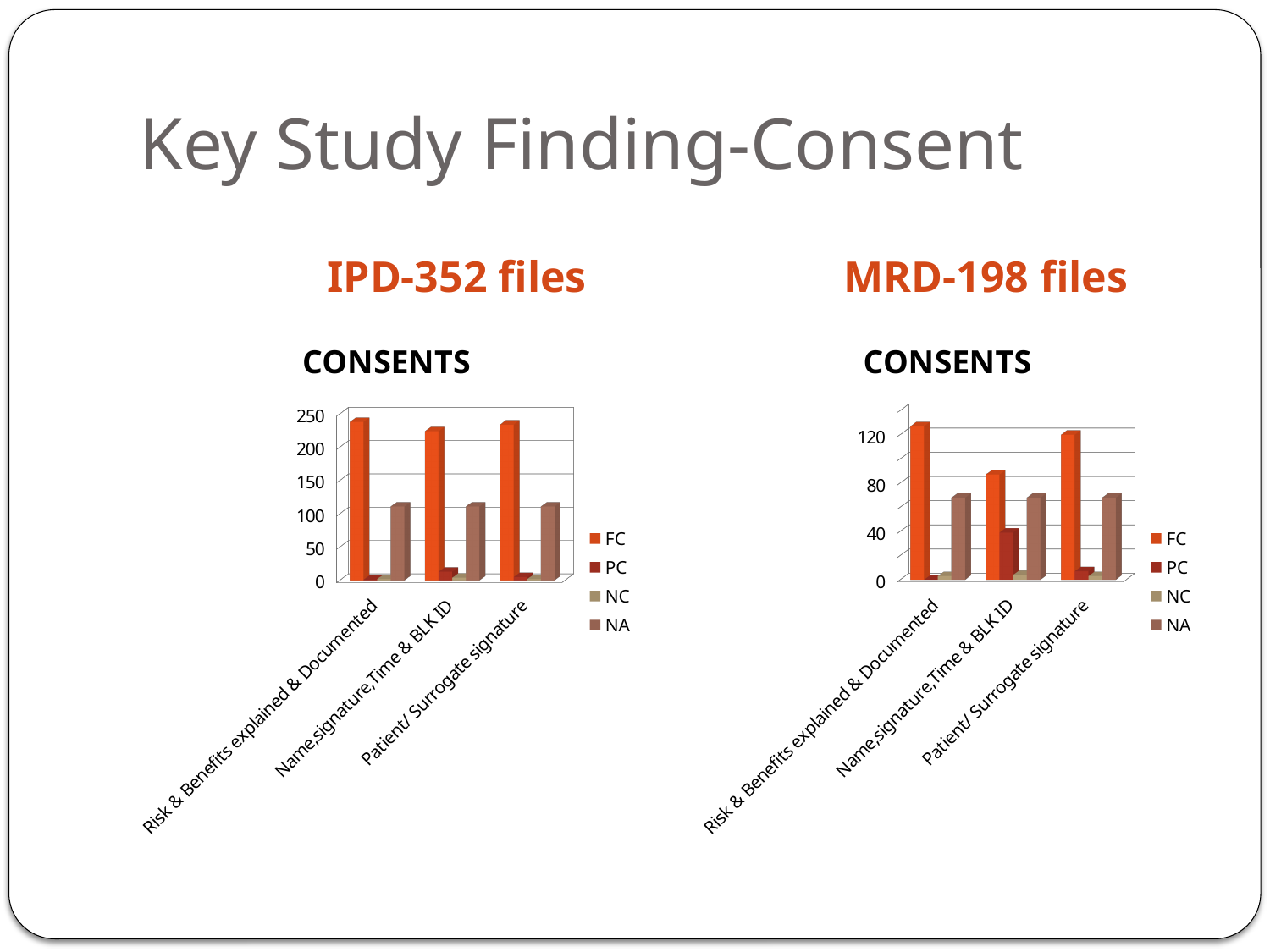
How many categories are shown on the x axis of the IPD-352 files chart on the left? 3 What kind of chart is the IPD-352 files chart on the left? bar chart What is the title shown above both charts? CONSENTS In the MRD-198 files chart on the right, which is larger for Name,signature,Time & BLK ID: FC or PC? FC In the MRD-198 files chart on the right, which category has the lowest FC value? Name,signature,Time & BLK ID In the IPD-352 files chart on the left, which is larger for Risk & Benefits explained & Documented: FC or NA? FC In the MRD-198 files chart on the right, which series has the highest value for Patient/ Surrogate signature? FC In the IPD-352 files chart on the left, is the NA value for Patient/ Surrogate signature greater or less than 150? less In the MRD-198 files chart on the right, is the NA value for Name,signature,Time & BLK ID greater or less than 80? less How many series does the legend of the MRD-198 files chart on the right list? 4 In the IPD-352 files chart on the left, is the FC value for Risk & Benefits explained & Documented greater or less than 200? greater